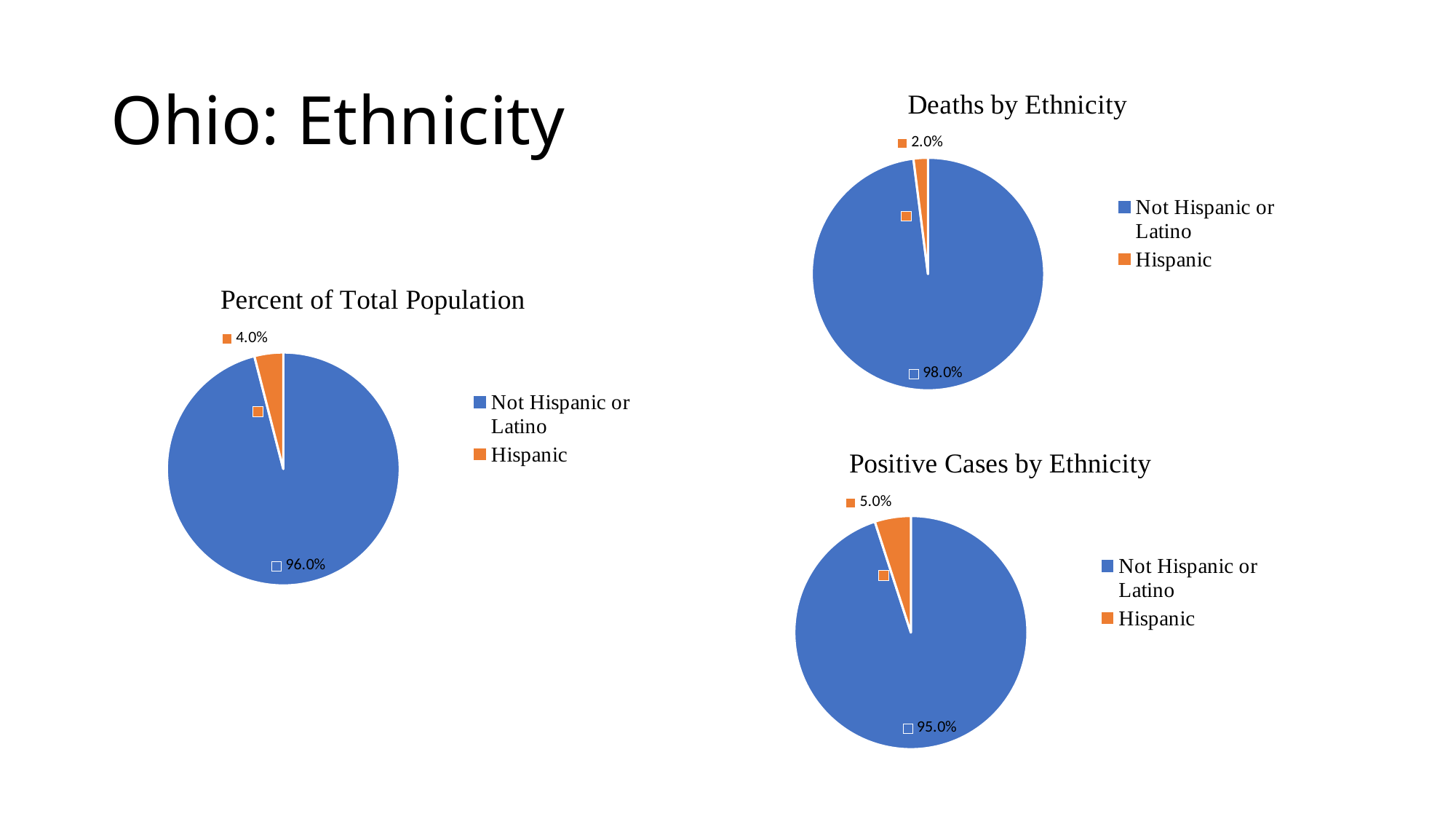
How many categories does the legend of the 'Positive Cases by Ethnicity' chart list? 2 In the 'Percent of Total Population' chart, what is the difference between the Not Hispanic or Latino share and the Hispanic share? 92.0% In the 'Deaths by Ethnicity' chart, which category has the largest slice? Not Hispanic or Latino In the 'Positive Cases by Ethnicity' chart, what share is labelled for Not Hispanic or Latino? 95.0% In the 'Percent of Total Population' chart, what share is labelled for Not Hispanic or Latino? 96.0% In the 'Positive Cases by Ethnicity' chart, which category has the smallest slice? Hispanic In the 'Percent of Total Population' chart, what share is labelled for Hispanic? 4.0% In the 'Deaths by Ethnicity' chart, what share is labelled for Hispanic? 2.0% In the 'Positive Cases by Ethnicity' chart, what share is labelled for Hispanic? 5.0% Is the Hispanic share larger in the 'Positive Cases by Ethnicity' chart or in the 'Deaths by Ethnicity' chart? Positive Cases by Ethnicity In the 'Deaths by Ethnicity' chart, what share is labelled for Not Hispanic or Latino? 98.0% What kind of chart is 'Deaths by Ethnicity'? Pie chart